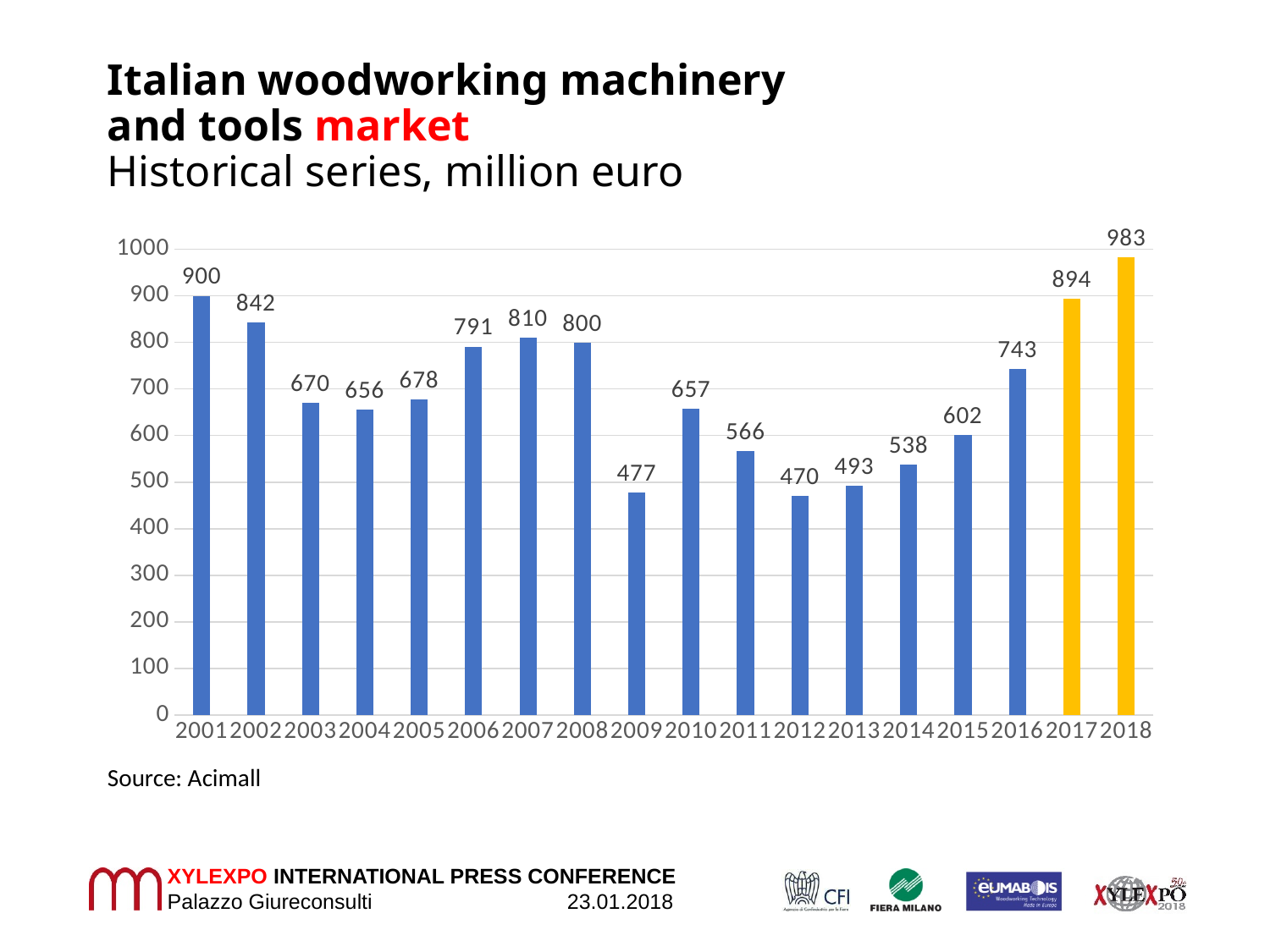
What kind of chart is this? Bar chart How many years are shown on the x axis? 18 What is the value for 2012? 470 What is the value for 2018? 983 What is the difference between the values for 2018 and 2017? 89 Which years are shown with yellow bars instead of blue? 2017 and 2018 Which year has the highest value? 2018 Which is larger, the value for 2007 or the value for 2008? 2007 What is the value for 2001? 900 Which year has the lowest value? 2012 What is the difference between the values for 2001 and 2009? 423 Do the values rise or fall from 2012 to 2018? Rise